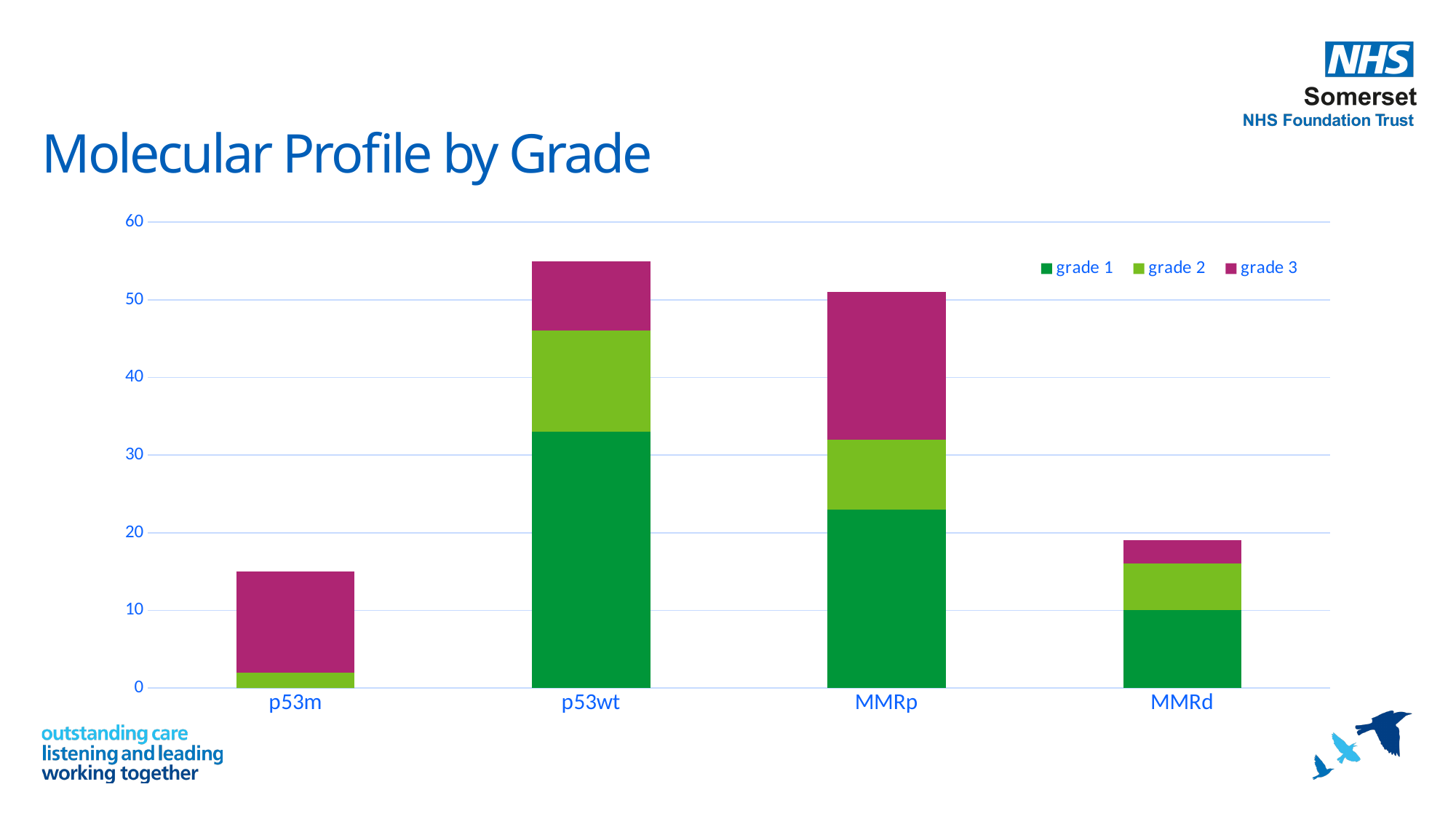
What is the title of the chart? Molecular Profile by Grade What kind of chart is shown on the slide? Stacked bar chart Which has the larger grade 1 value, p53wt or MMRp? p53wt Is the total stacked value for p53m greater or less than 20? less Is the total stacked value for MMRp greater or less than 40? greater Which category has the tallest stacked bar overall? p53wt How many series does the legend list? 3 Which category has the shortest stacked bar overall? p53m Which legend entry is shown in magenta? grade 3 Is the total stacked value for p53wt greater or less than 50? greater How many categories are shown on the x axis? 4